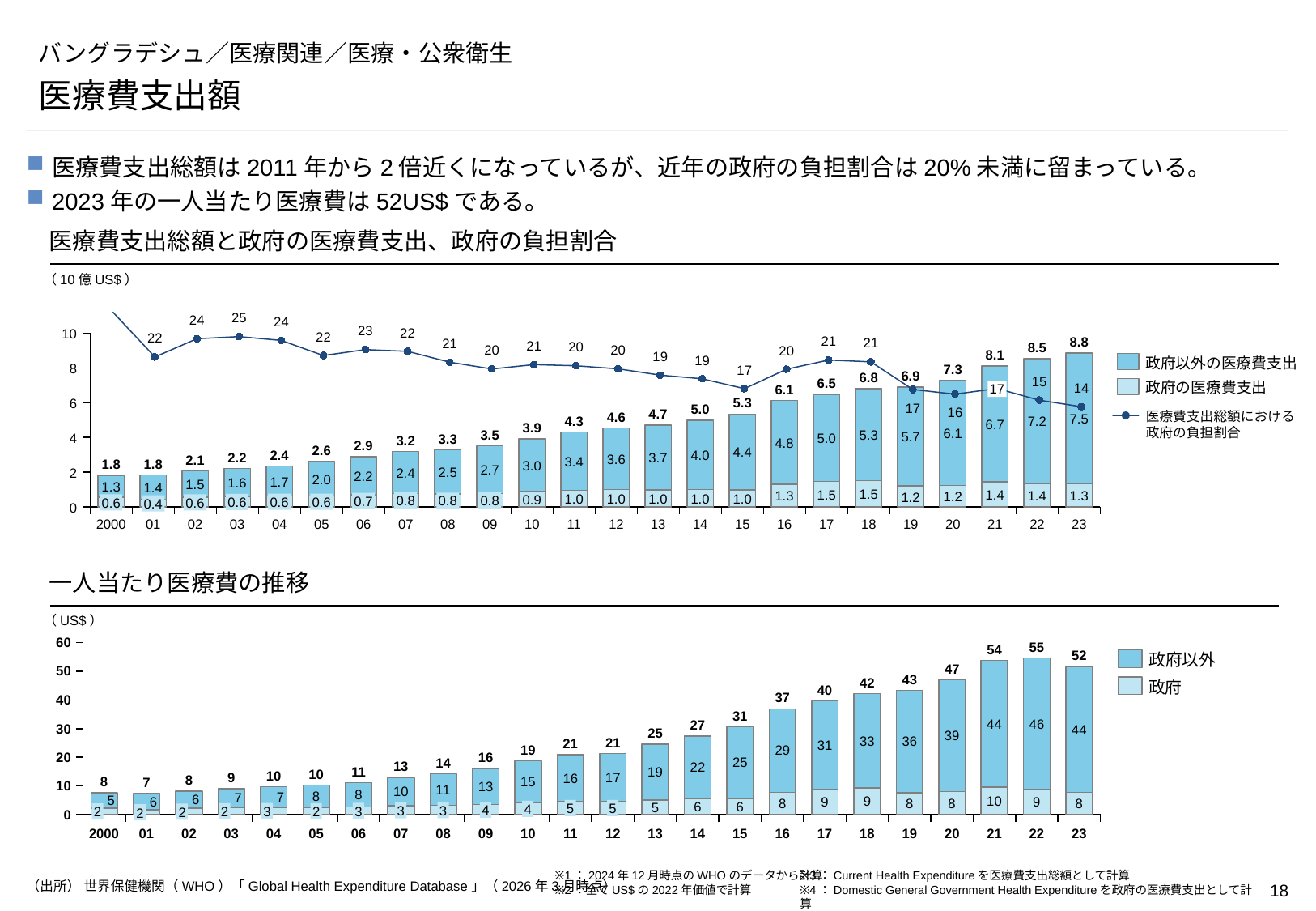
In the top chart (医療費支出総額と政府の医療費支出、政府の負担割合), what is the total health expenditure for 2023? 8.8 In the bottom chart, which year has the lowest per-capita health expenditure? 01 In the bottom chart (一人当たり医療費の推移), what is the per-capita health expenditure for 2022? 55 In the top chart, what is the government health expenditure (政府の医療費支出) for 2017? 1.5 In the top chart, what is the difference between the total health expenditure in 2023 and in 2011? 4.5 In the top chart, what is the government share (政府の負担割合) shown for 2003? 25 In the top chart, how many series does the legend list? 3 In the bottom chart, is the per-capita value for 2021 larger or smaller than the value for 2023? larger In the bottom chart, what is the non-government (政府以外) per-capita value for 2020? 39 In the top chart, does the government share line generally rise or fall from 2017 to 2023? fall In the top chart, which year has the highest total health expenditure? 23 What type of chart is the bottom chart (一人当たり医療費の推移)? stacked bar chart